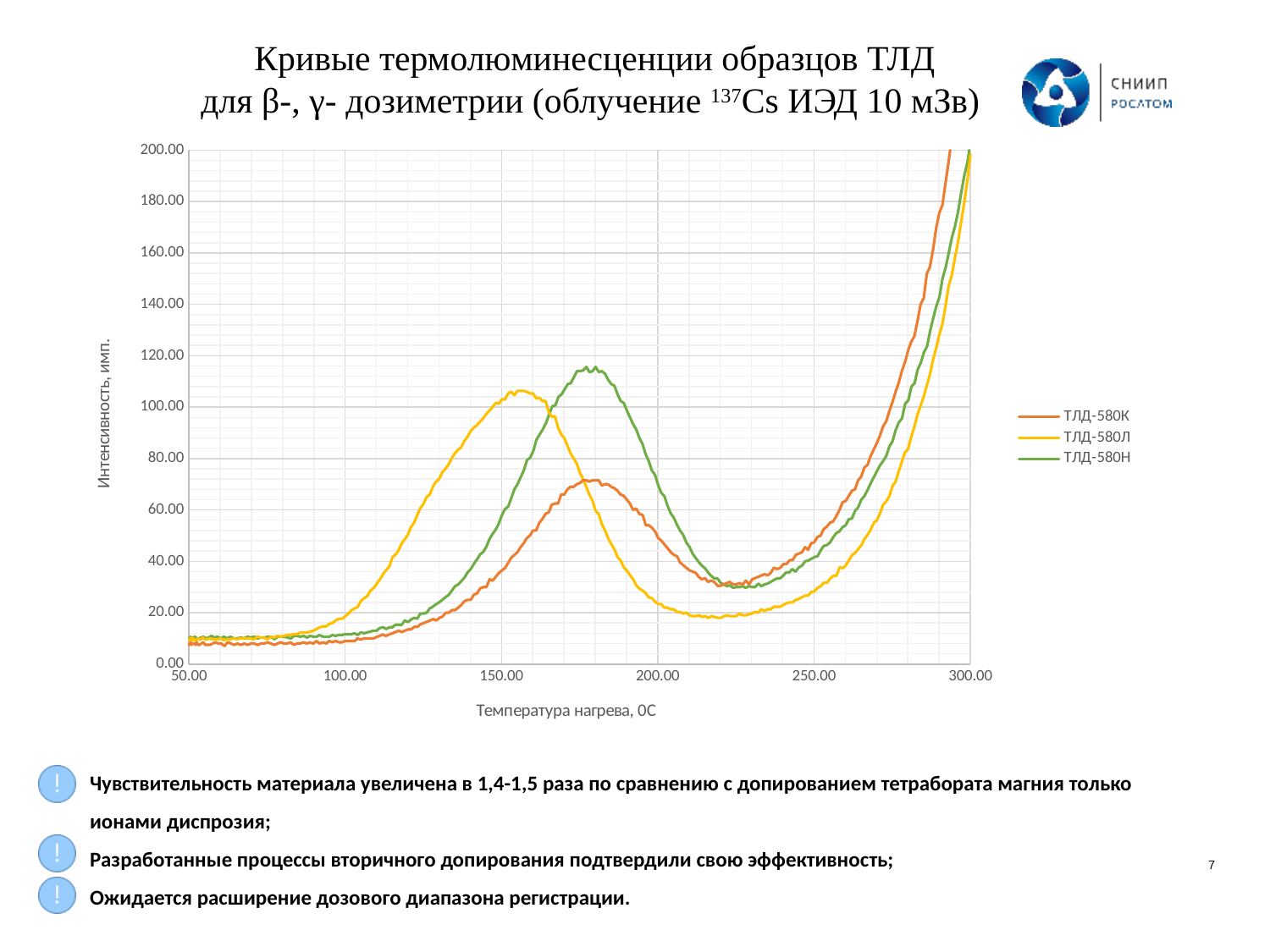
Do the intensity values of all three series rise or fall between 250 °C and 300 °C? rise Is the peak value of ТЛД-580Л near 155 °C greater or less than 100? greater How many series does the legend list? 3 What is the label of the x axis? Температура нагрева, 0С Which series reaches the highest peak intensity in the 150–200 °C region? ТЛД-580Н Is the peak value of ТЛД-580К near 180 °C greater or less than 80? less Which series has the lowest peak intensity in the 150–200 °C region? ТЛД-580К What kind of chart is shown on the slide? Line chart What are the names of the series listed in the legend? ТЛД-580К, ТЛД-580Л, ТЛД-580Н At 150 °C, which series has the larger intensity, ТЛД-580Л or ТЛД-580К? ТЛД-580Л Which series peaks at a lower temperature, ТЛД-580Л or ТЛД-580Н? ТЛД-580Л